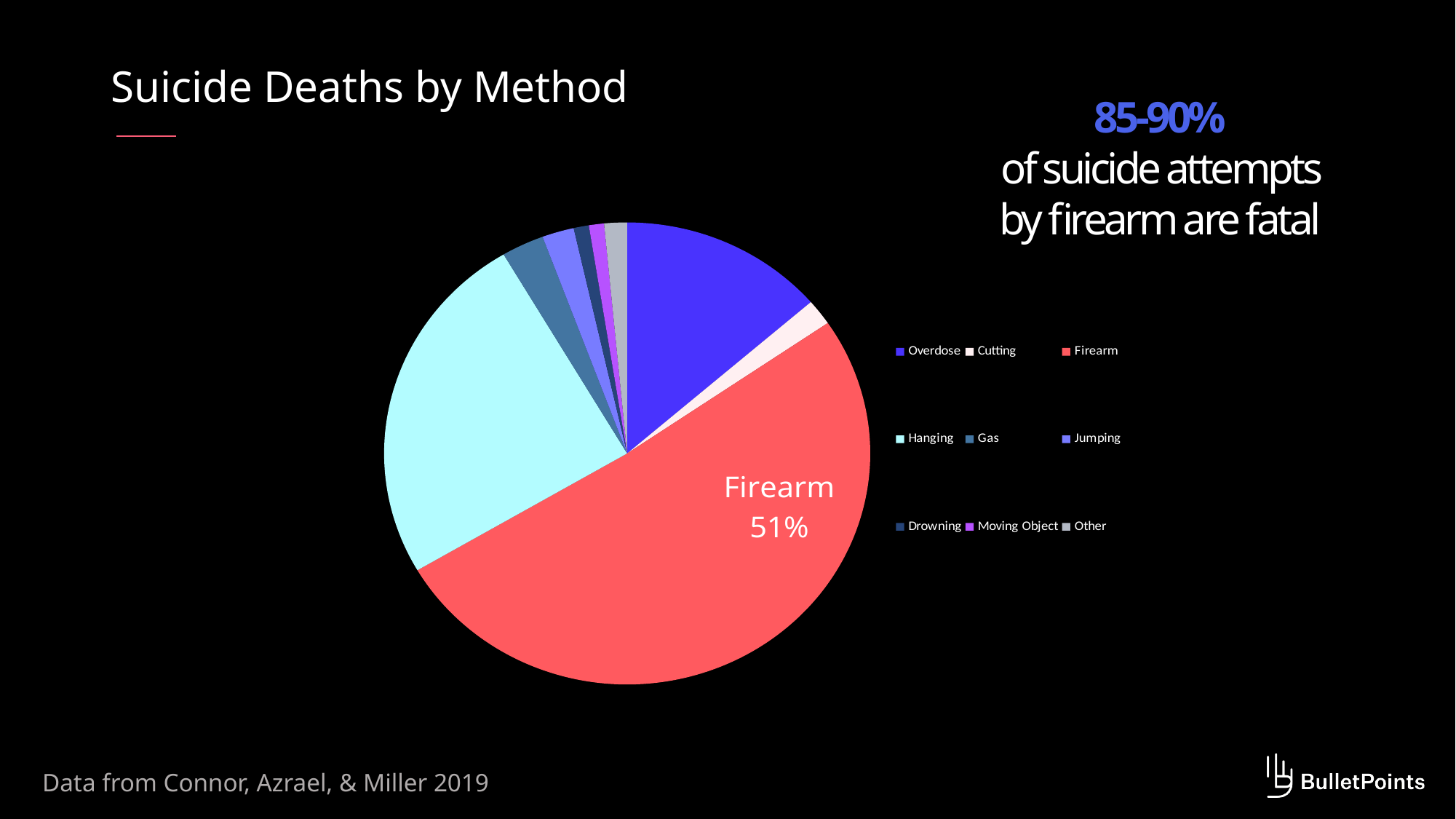
What colour is the Firearm slice in the pie chart? red Is the Firearm share greater or less than 50%? greater How many categories does the pie chart's legend list? 9 What share of the pie does Firearm account for? 51% Which slice is larger, Overdose or Cutting? Overdose What value is printed on the Firearm slice? 51% Which slice is larger, Hanging or Overdose? Hanging What is the title of the chart? Suicide Deaths by Method Which slice is larger, Firearm or Hanging? Firearm Which method has the largest slice of the pie? Firearm What kind of chart is shown on the slide? pie chart